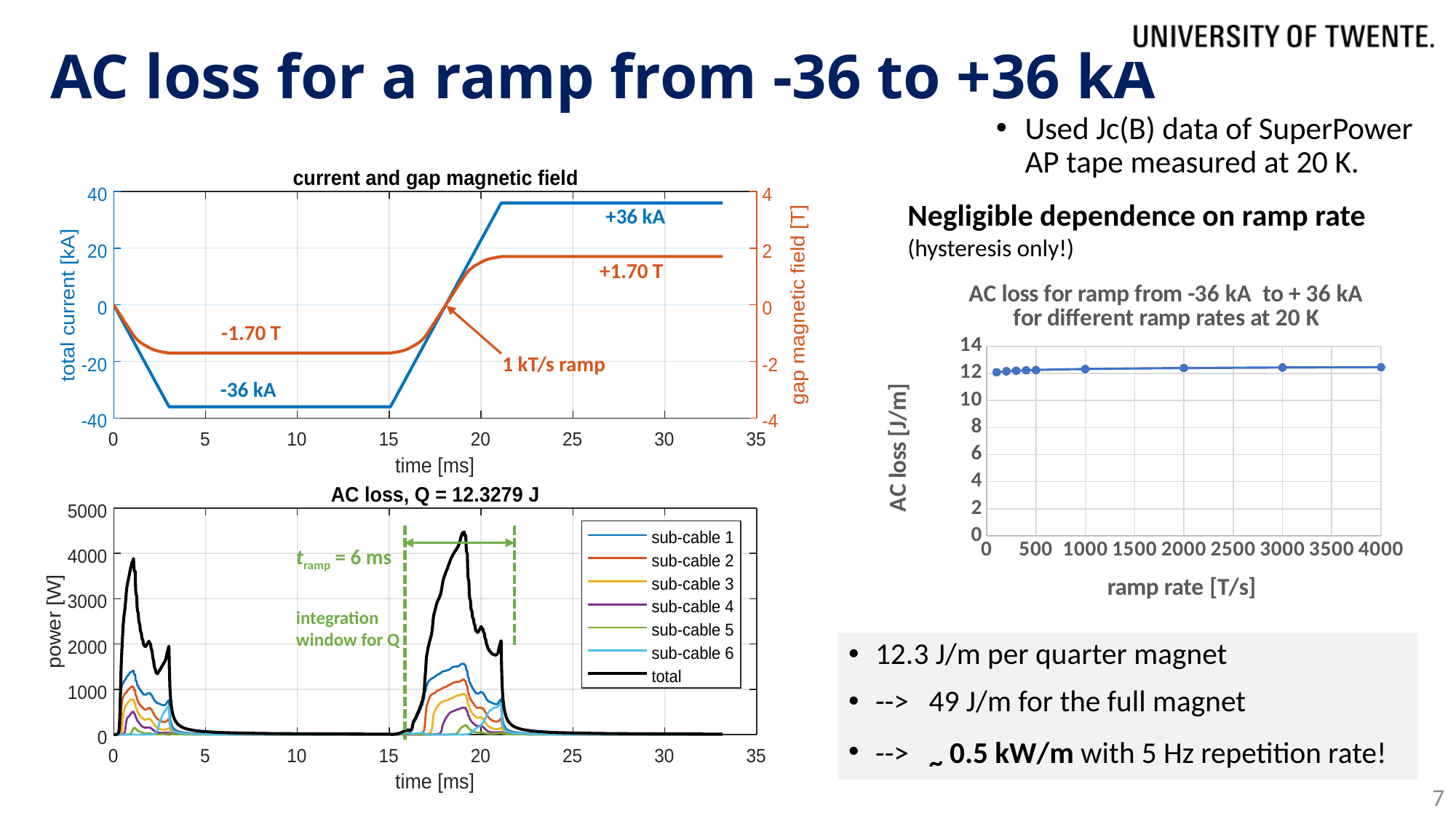
In the 'current and gap magnetic field' chart, what is the unit of the right-hand y axis? T In the 'AC loss, Q = 12.3279 J' chart, is the peak of the 'total' curve inside the integration window greater or less than 4000 W? greater In the 'current and gap magnetic field' chart, what ramp rate is annotated next to the arrow on the magnetic field curve? 1 kT/s ramp In the 'AC loss, Q = 12.3279 J' chart, what value of Q is given in the title? 12.3279 J In the 'AC loss, Q = 12.3279 J' chart, which legend entry is drawn in black? total In the 'AC loss, Q = 12.3279 J' chart, what is the annotated ramp time t_ramp? 6 ms In the 'AC loss for ramp from -36 kA to + 36 kA for different ramp rates at 20 K' chart, what is the label of the x axis? ramp rate [T/s] In the 'AC loss for ramp from -36 kA to + 36 kA for different ramp rates at 20 K' chart, is the AC loss at a ramp rate of 4000 T/s greater or less than 10 J/m? greater In the 'AC loss, Q = 12.3279 J' chart, how many entries does the legend list? 7 In the 'current and gap magnetic field' chart, what is the labelled gap magnetic field value before the ramp? -1.70 T What kind of chart is the 'current and gap magnetic field' chart? line chart In the 'current and gap magnetic field' chart, what is the plateau value of the total current after the ramp, as labelled on the plot? +36 kA